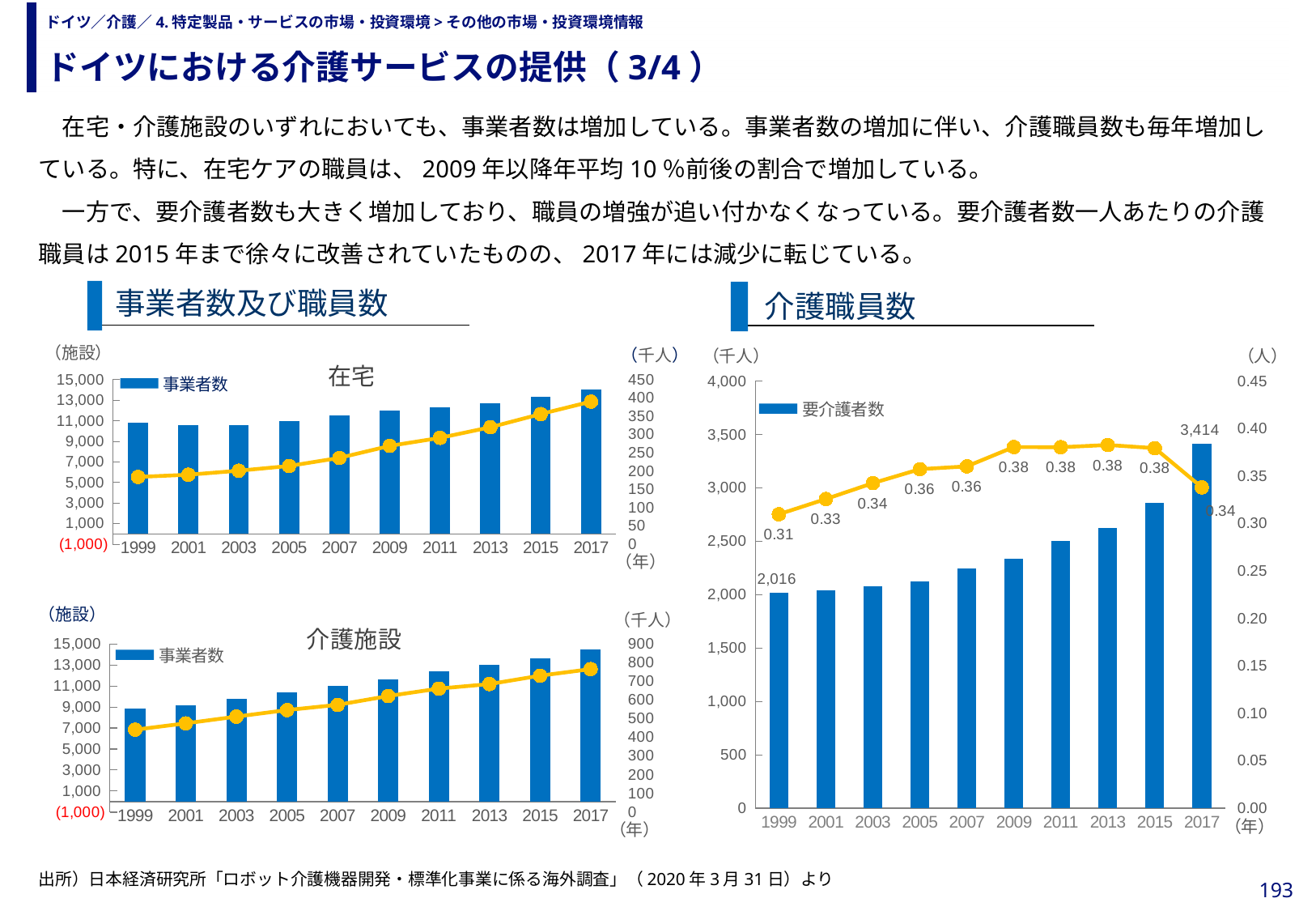
In the 在宅 chart on the top left, is the 事業者数 bar for 2017 greater or less than 13,000? greater In the 介護職員数 chart on the right, what is the value of the line series for 1999? 0.31 In the 介護職員数 chart on the right, which is larger, the line value for 2015 or for 2017? 2015 In the 介護施設 chart on the bottom left, is the 事業者数 bar for 1999 greater or less than 11,000? less In the 介護職員数 chart on the right, what is the value of the line series for 2017? 0.34 In the 在宅 chart on the top left, do the 事業者数 bars generally rise or fall from 1999 to 2017? rise In the 介護職員数 chart on the right, what is the value of 要介護者数 for 1999? 2,016 In the 介護職員数 chart on the right, what is the difference between the 要介護者数 values for 2017 and 1999? 1,398 In the 介護職員数 chart on the right, what series name is shown in the legend? 要介護者数 In the 介護職員数 chart on the right, what is the value of 要介護者数 for 2017? 3,414 In the 介護職員数 chart on the right, which year has the lowest value on the line series? 1999 In the 介護職員数 chart on the right, how many years are shown on the x axis? 10